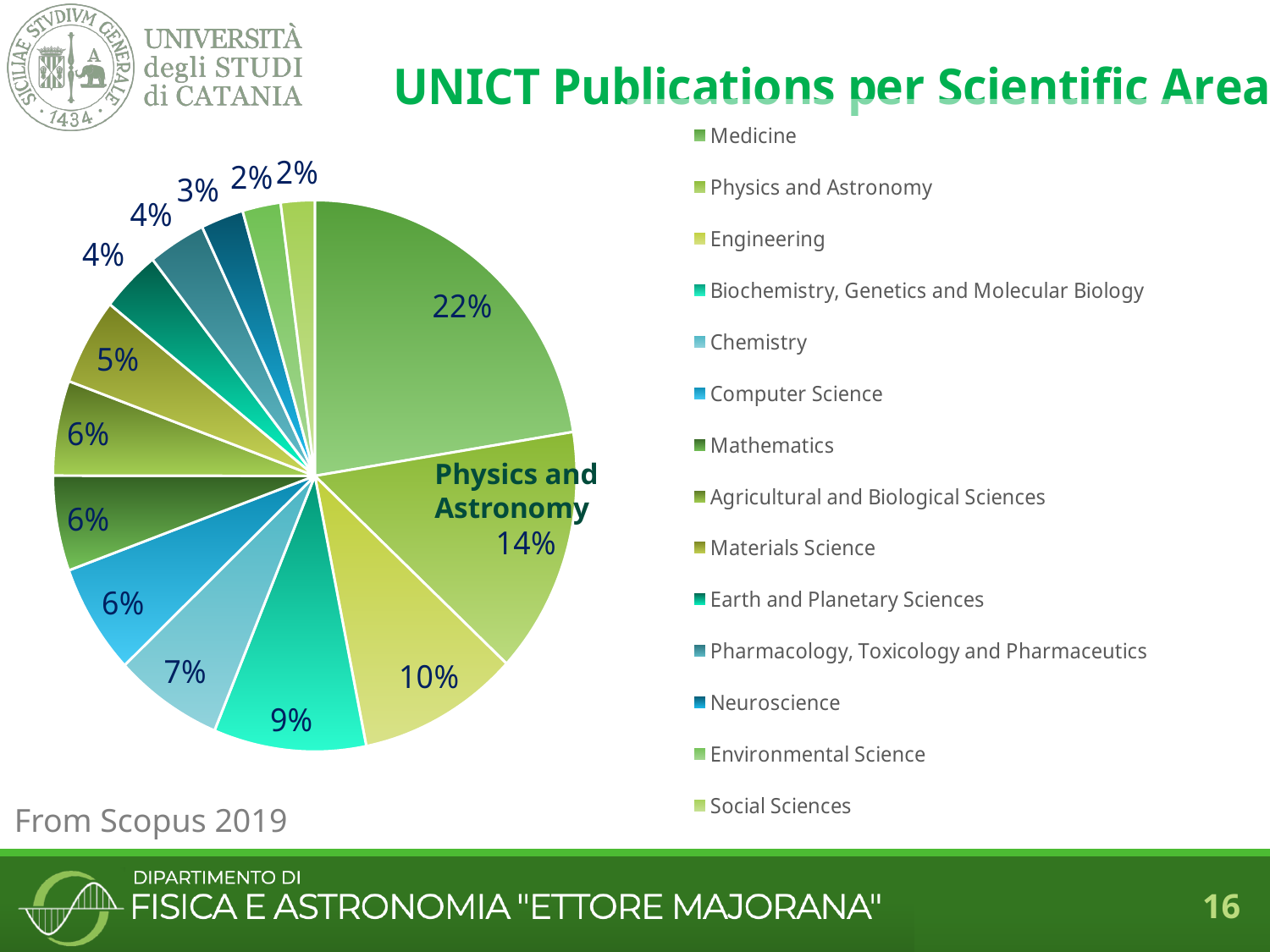
How many scientific areas are listed in the legend? 14 What is the title of the chart? UNICT Publications per Scientific Area What is the difference in percentage points between the Medicine share and the Physics and Astronomy share? 8 What share of UNICT publications is attributed to Physics and Astronomy? 14% What is the source of the data shown in the chart? Scopus 2019 What share of UNICT publications is attributed to Medicine? 22% Which has a larger share of publications, Engineering or Chemistry? Engineering What share of UNICT publications is attributed to Biochemistry, Genetics and Molecular Biology? 9% What share of UNICT publications is attributed to Engineering? 10% Which scientific area has the largest share of UNICT publications? Medicine What type of chart is shown on the slide? pie chart What share of UNICT publications is attributed to Chemistry? 7%